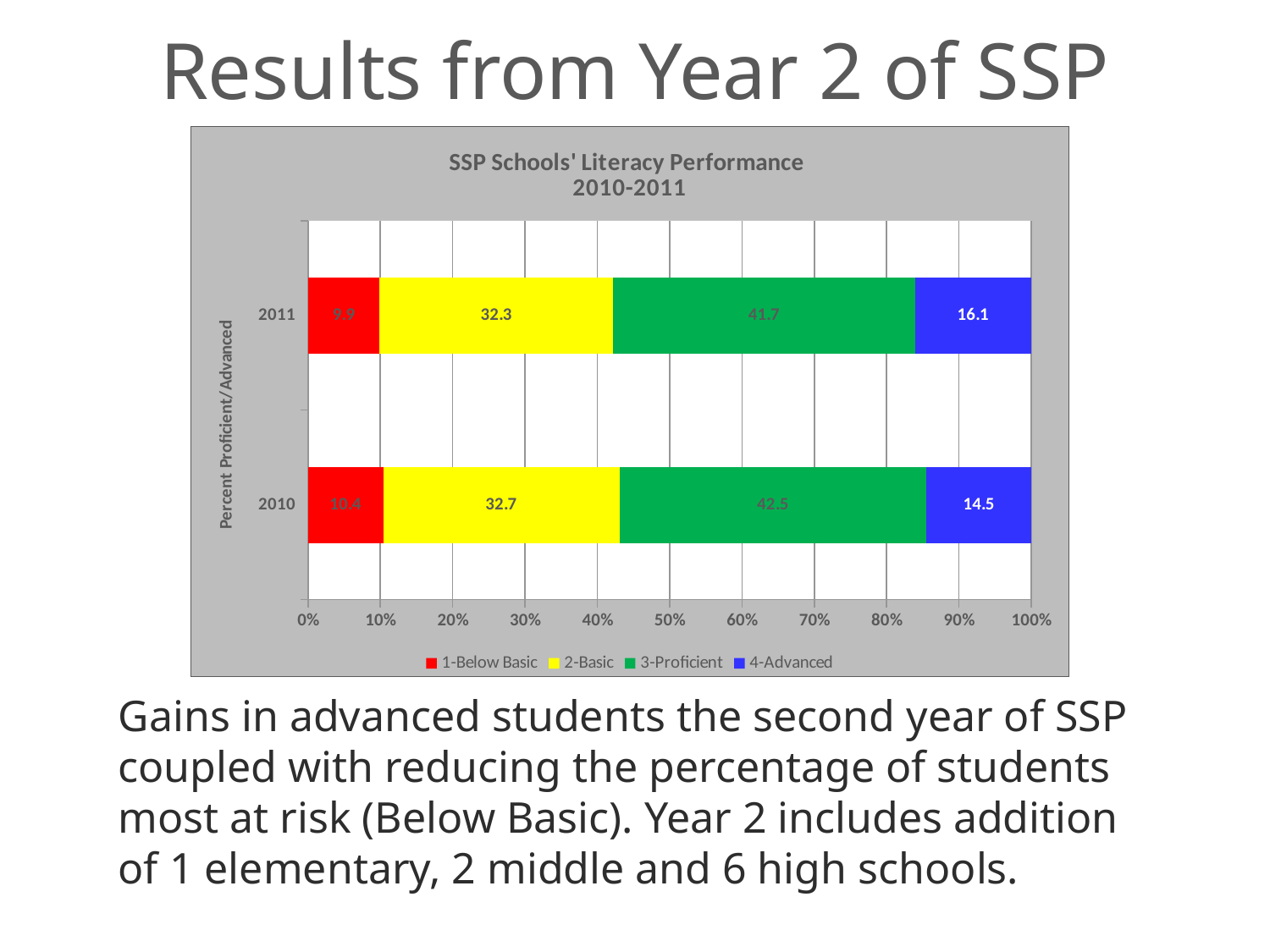
How many series does the legend list? 4 What is the value for 4-Advanced in 2011? 16.1 What is the value for 3-Proficient in 2010? 42.5 What is the value for 2-Basic in 2011? 32.3 How many years (categories) are shown on the chart? 2 What is the value for 1-Below Basic in 2010? 10.4 Which series has the smallest value in the 2010 bar? 1-Below Basic What is the title of the chart? SSP Schools' Literacy Performance 2010-2011 Which year has the larger 1-Below Basic value, 2010 or 2011? 2010 What kind of chart is shown on the slide? Stacked bar chart Which series has the largest value in the 2011 bar? 3-Proficient What is the difference between the 4-Advanced values for 2011 and 2010? 1.6